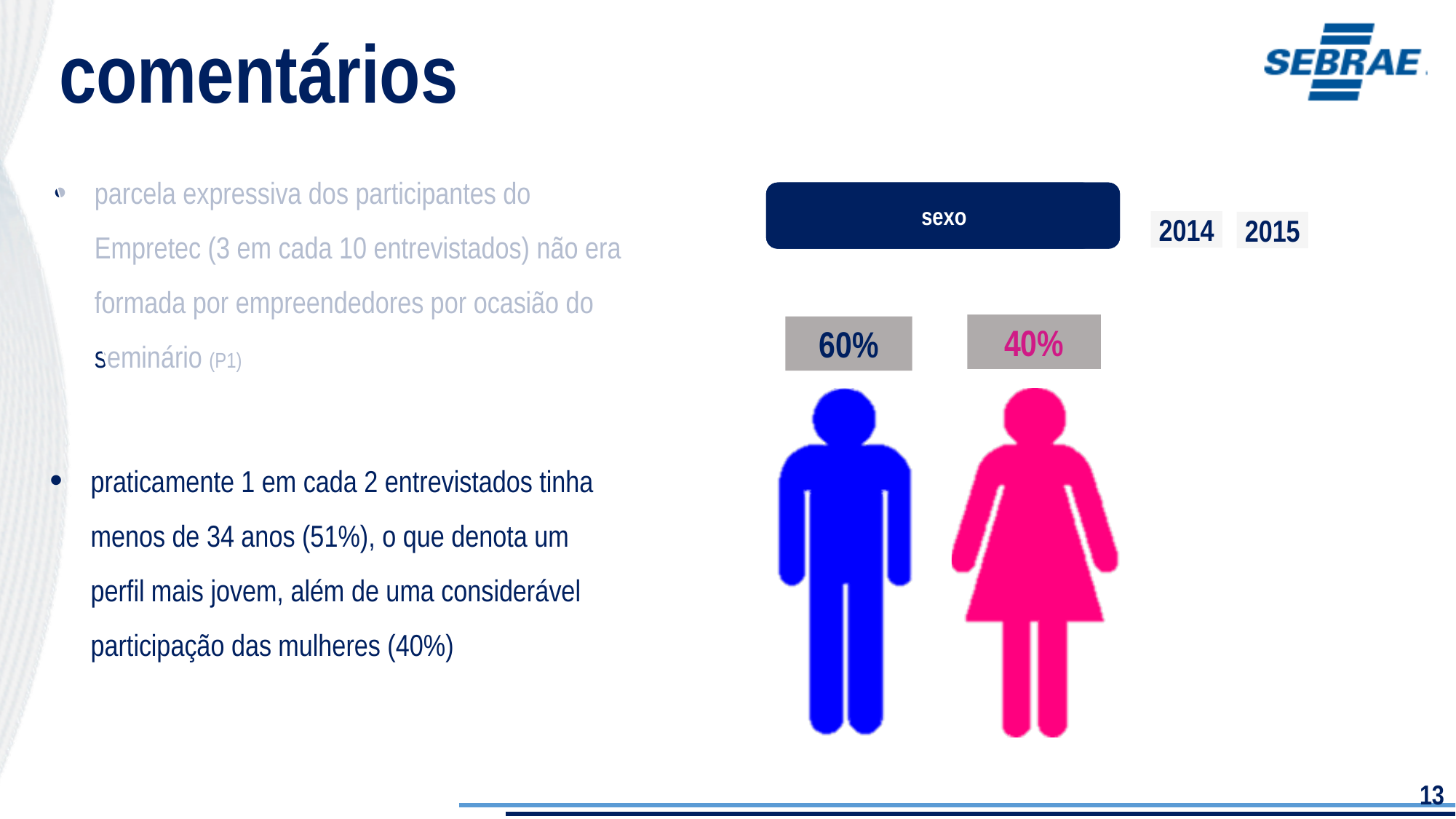
In the 'sexo' graphic, what is the difference between the male and female percentages? 20% How many groups are shown in the 'sexo' graphic? 2 In the 'sexo' graphic, which group has the larger share, men or women? men In the 'sexo' graphic, which group has the smaller share, men or women? women What is the total of the two percentages shown in the 'sexo' graphic? 100% In the 'sexo' graphic, what percentage is shown above the pink female figure? 40% What is the title shown in the dark box above the figures? sexo In the 'sexo' graphic, what percentage is shown above the blue male figure? 60% What colour is the male figure in the 'sexo' graphic? blue In the 'sexo' graphic, is the male share greater or less than 50%? greater In the 'sexo' graphic, is the female share greater or less than 50%? less